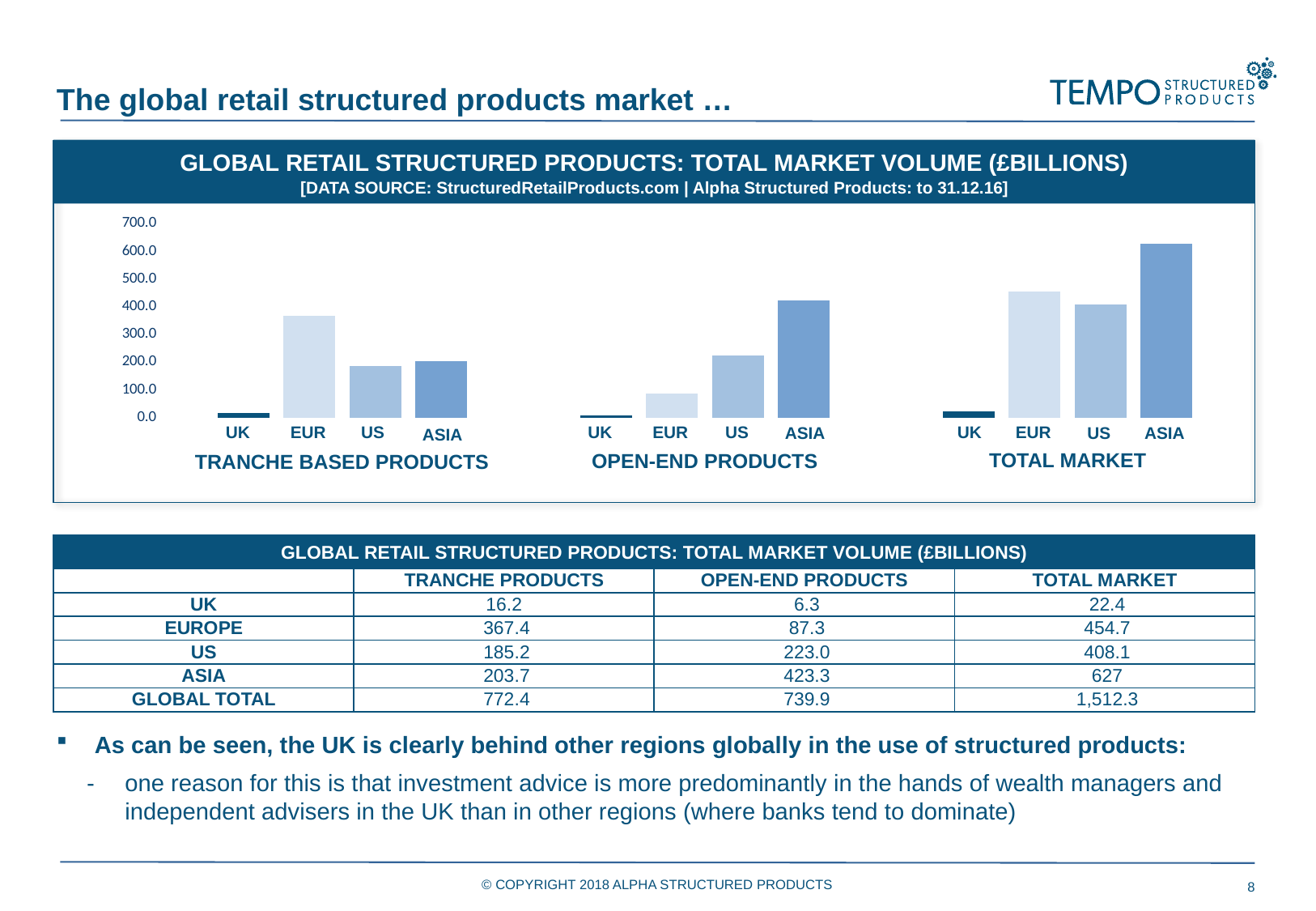
In the Open-End Products group, do the bars rise or fall from UK to ASIA? rise According to the slide, what is the Total Market volume for ASIA in £billions? 627 How many regions are plotted in each group of the chart? 4 What is the difference between the Total Market values for ASIA and EUROPE shown on the slide? 172.3 In the Total Market group, which is larger, the bar for EUR or the bar for US? EUR In the Tranche Based Products group of the chart, which region has the lowest bar? UK In the Open-End Products group of the chart, which region has the highest bar? ASIA In the Tranche Based Products group, is the value for EUR greater or less than 300.0? greater According to the slide, what is the Tranche Products volume for the UK in £billions? 16.2 In the Total Market group of the chart, which region has the highest bar? ASIA In the Total Market group, is the value for EUR greater or less than 500.0? less What kind of chart is shown on the slide? bar chart